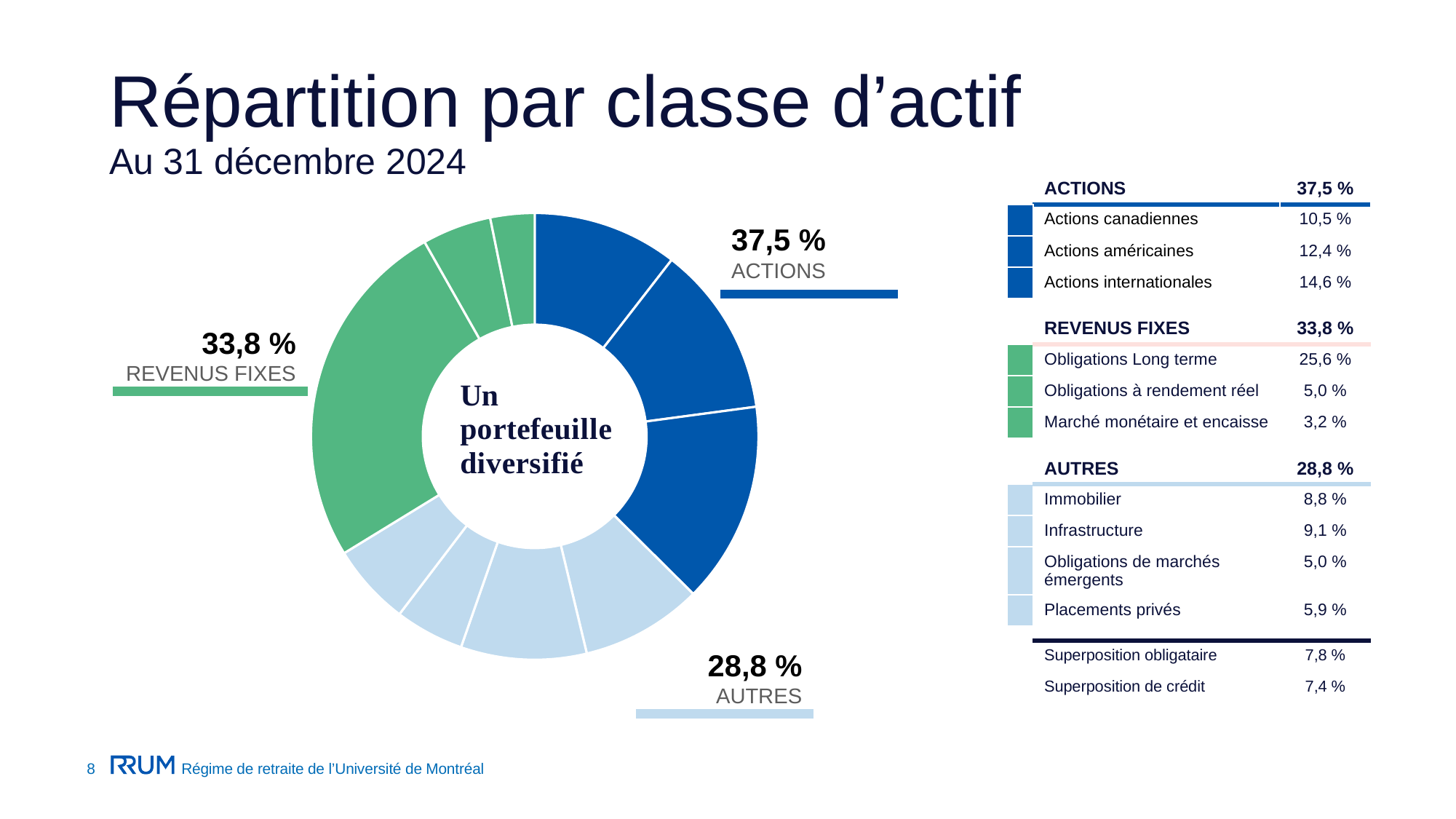
What kind of chart is used to show the asset allocation? Donut (pie) chart What text is written in the centre of the donut chart? Un portefeuille diversifié What is the difference in percentage points between ACTIONS and REVENUS FIXES? 3,7 % Which of the three asset classes has the largest share of the portfolio? ACTIONS What percentage does the donut chart show for REVENUS FIXES? 33,8 % What percentage does the donut chart show for AUTRES? 28,8 % What percentage of the portfolio is allocated to ACTIONS in the donut chart? 37,5 % According to the table beside the chart, what percentage is allocated to Obligations Long terme? 25,6 % Which of the three asset classes has the smallest share of the portfolio? AUTRES What is the difference in percentage points between REVENUS FIXES and AUTRES? 5,0 % Which is larger, the share for ACTIONS or the share for AUTRES? ACTIONS How many individual slices make up the donut chart? 10